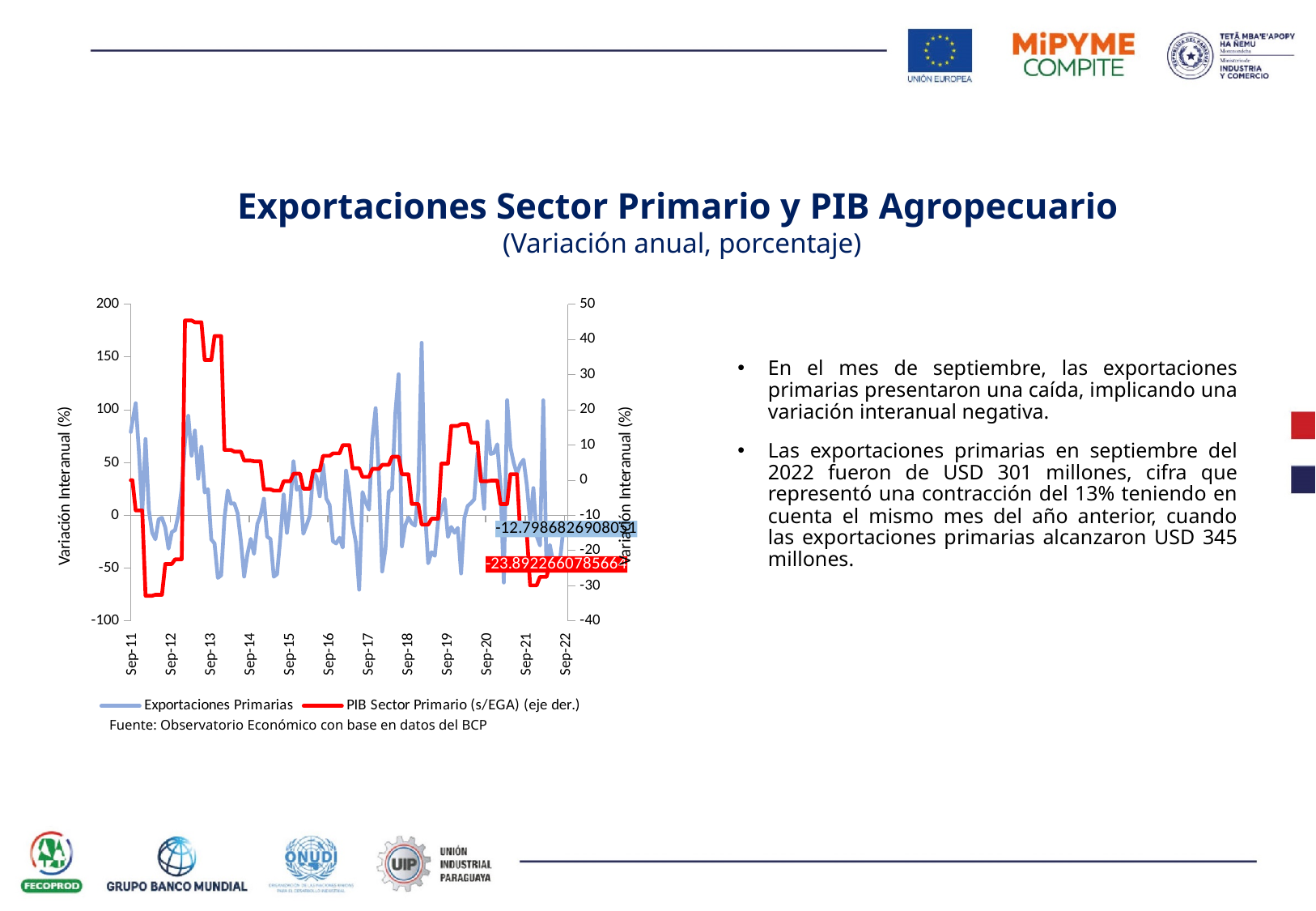
What is the first date label and the last date label on the x axis? Sep-11 and Sep-22 What are the two series named in the chart legend? Exportaciones Primarias; PIB Sector Primario (s/EGA) (eje der.) Is the last value of the Exportaciones Primarias series greater or less than -50? greater How many date labels are shown on the x axis of the chart? 12 Is the highest value of the Exportaciones Primarias series (around Sep-18) greater or less than 150? greater What is the last labelled value of the PIB Sector Primario (s/EGA) series? -23.8922660785664 Is the last value of the Exportaciones Primarias series greater or less than 0? less How many series does the chart legend list? 2 What is the title of the chart on the slide? Exportaciones Sector Primario y PIB Agropecuario What kind of chart is shown on the slide? line chart